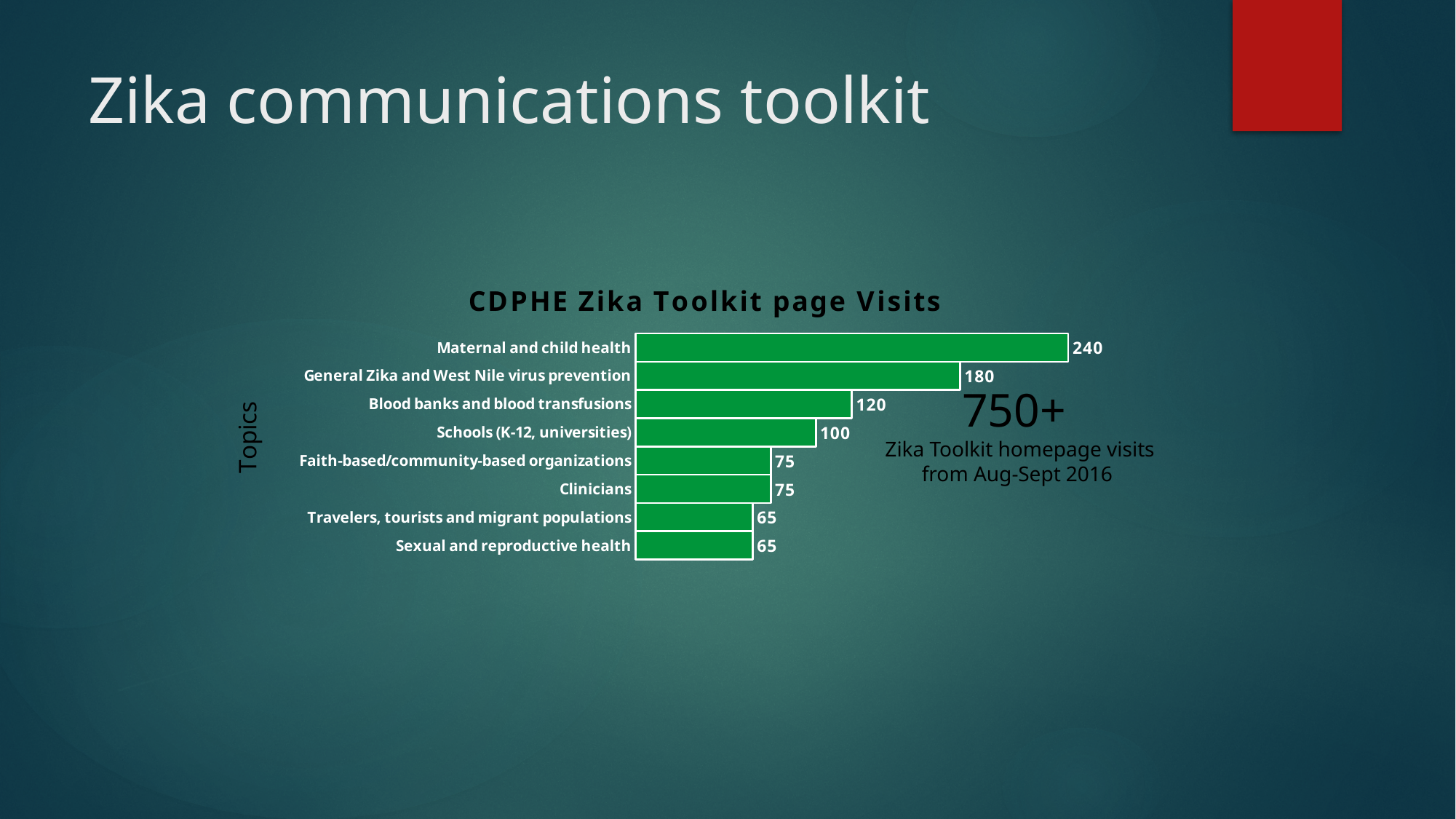
What is the value for Clinicians? 75 What is the value for Maternal and child health? 240 How many topics are shown in the chart? 8 What is the difference between the values for Maternal and child health and General Zika and West Nile virus prevention? 60 Which topic has the highest number of page visits? Maternal and child health What is the label on the vertical axis of the chart? Topics What kind of chart is shown on the slide? Bar chart What is the value for Blood banks and blood transfusions? 120 What is the value for Schools (K-12, universities)? 100 Which is larger, the value for General Zika and West Nile virus prevention or the value for Schools (K-12, universities)? General Zika and West Nile virus prevention What is the title of the chart? CDPHE Zika Toolkit page Visits What is the difference between the values for Blood banks and blood transfusions and Sexual and reproductive health? 55